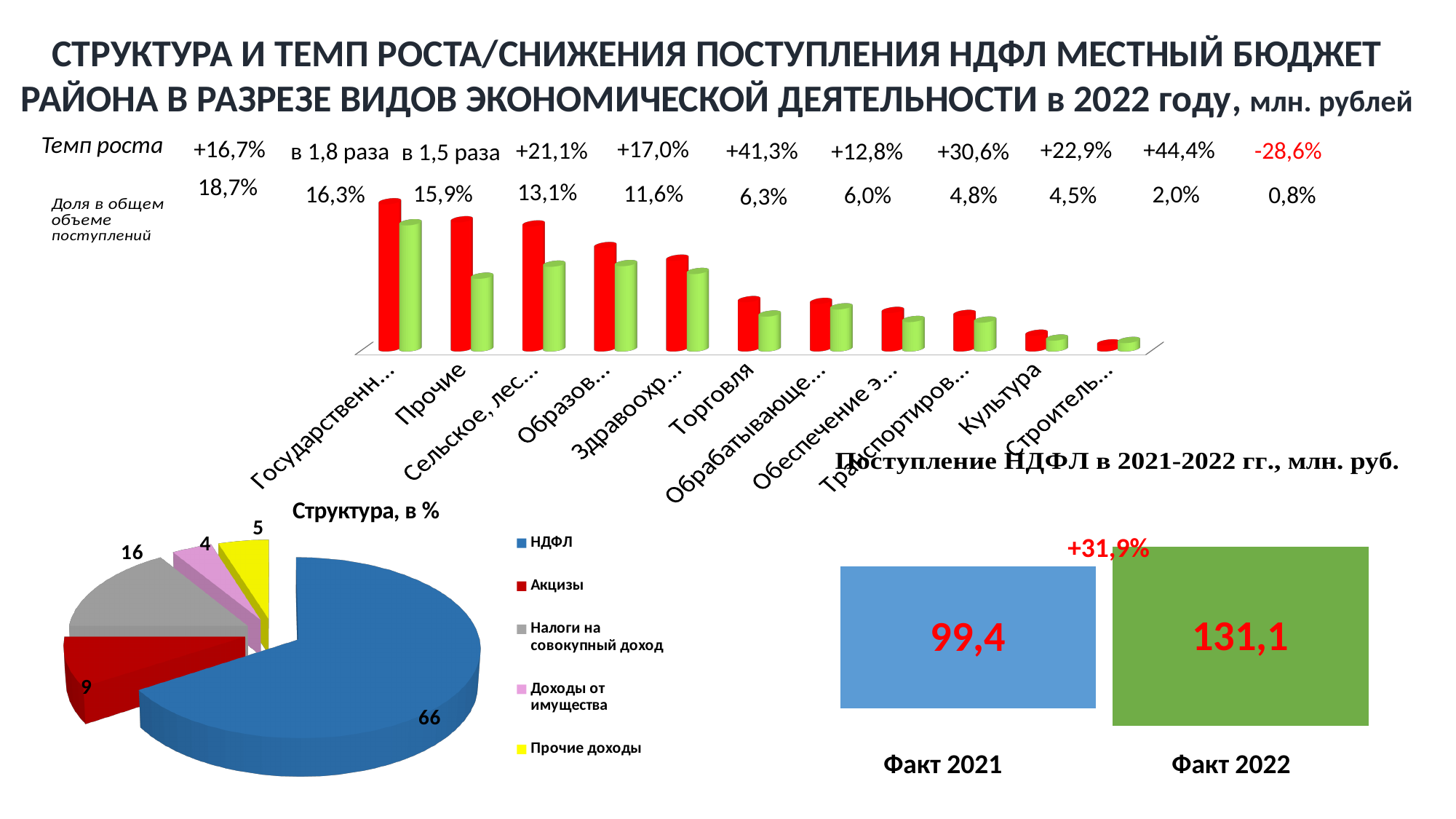
How many entries does the legend of the pie chart 'Структура, в %' list? 5 In the chart 'Поступление НДФЛ в 2021-2022 гг., млн. руб.', what percentage change is shown between Факт 2021 and Факт 2022? +31,9% In the pie chart 'Структура, в %', what is the difference between the values for НДФЛ and Акцизы? 57 In the pie chart 'Структура, в %', what is the value for НДФЛ? 66 In the chart 'Поступление НДФЛ в 2021-2022 гг., млн. руб.', what is the value for Факт 2022? 131,1 In the chart 'Поступление НДФЛ в 2021-2022 гг., млн. руб.', what is the value for Факт 2021? 99,4 What kind of chart is the chart at the top of the slide showing economic activity types? bar chart In the chart 'Поступление НДФЛ в 2021-2022 гг., млн. руб.', which is larger, Факт 2021 or Факт 2022? Факт 2022 In the pie chart 'Структура, в %', which category has the largest slice? НДФЛ In the top bar chart, what share in total receipts (Доля в общем объеме поступлений) is shown for Торговля? 6,3% In the pie chart 'Структура, в %', which category has the smallest slice? Доходы от имущества In the pie chart 'Структура, в %', what is the value for Налоги на совокупный доход? 16